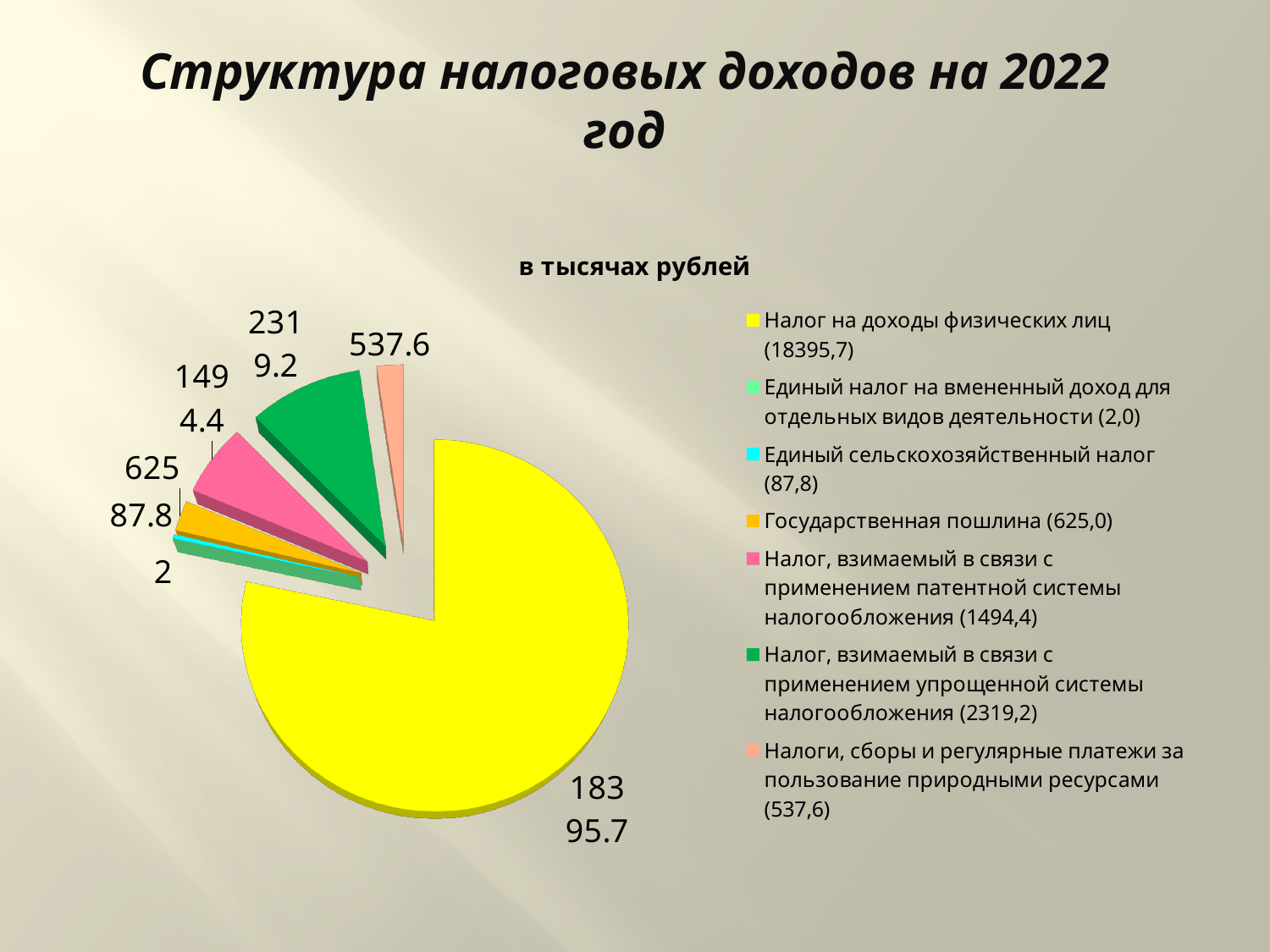
What is the value shown for Налоги, сборы и регулярные платежи за пользование природными ресурсами? 537.6 What value does the legend give for Налог, взимаемый в связи с применением упрощенной системы налогообложения? 2319,2 What is the value shown for Государственная пошлина? 625 How many entries does the legend list? 7 Which category has the largest slice of the pie? Налог на доходы физических лиц Which is larger: Государственная пошлина or Единый сельскохозяйственный налог? Государственная пошлина Which category has the smallest slice of the pie? Единый налог на вмененный доход для отдельных видов деятельности What unit is stated above the chart? в тысячах рублей How many categories does the pie chart have? 7 What is the value shown for Единый сельскохозяйственный налог? 87.8 What is the difference between the values for Государственная пошлина (625) and Единый сельскохозяйственный налог (87.8)? 537.2 What kind of chart is shown on the slide? pie chart